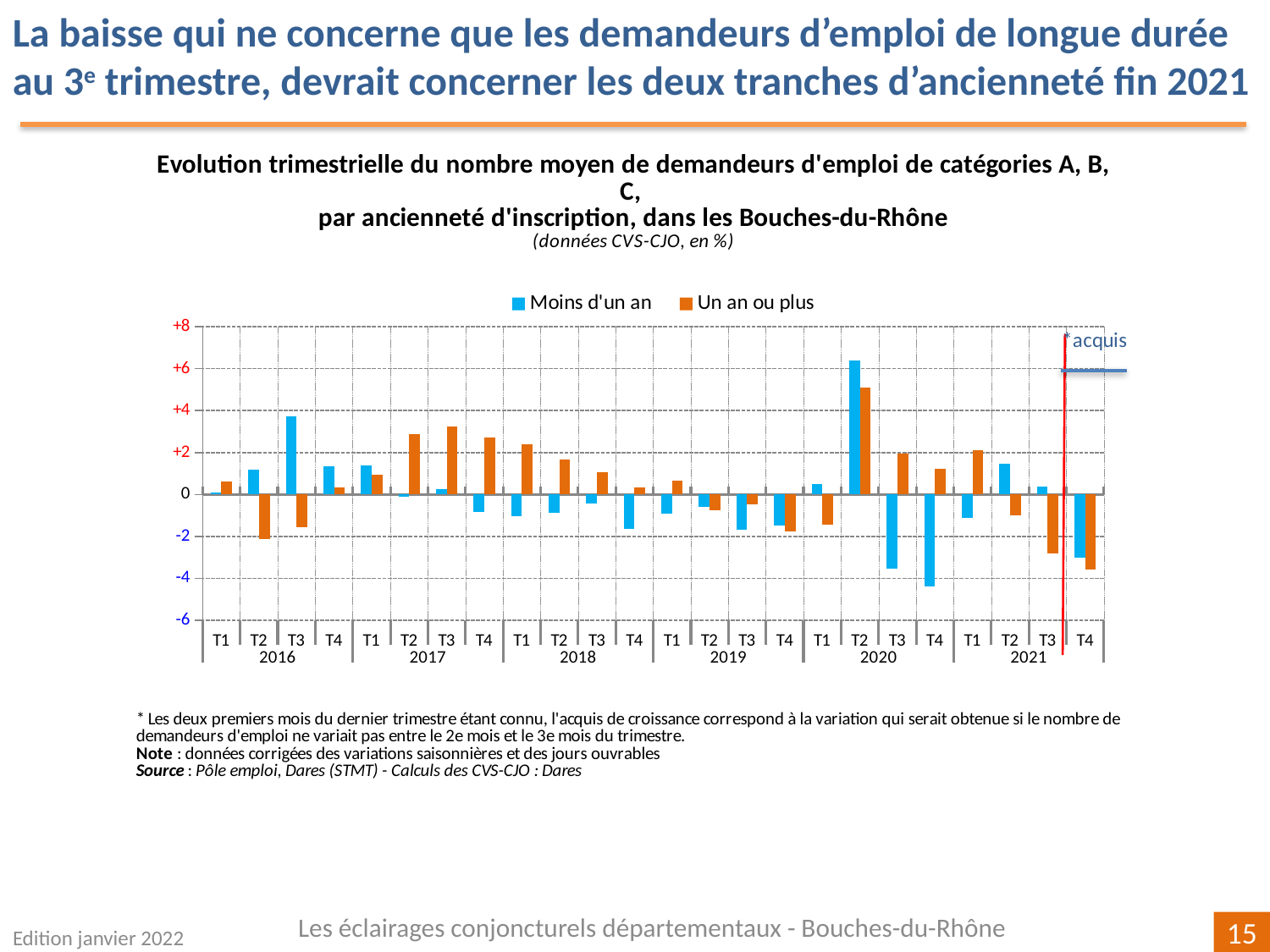
Is the value for 'Moins d'un an' in T2 2020 greater or less than +4? greater What kind of chart is shown on the slide? bar chart In which quarter is the value for 'Un an ou plus' lowest? T4 2021 In T2 2020, which series has the larger value, 'Moins d'un an' or 'Un an ou plus'? Moins d'un an In which quarter is the value for 'Un an ou plus' highest? T2 2020 Is the value for 'Un an ou plus' in T3 2017 greater or less than +2? greater In which quarter is the value for 'Moins d'un an' highest? T2 2020 In which quarter is the value for 'Moins d'un an' lowest? T4 2020 What are the two series named in the legend? Moins d'un an; Un an ou plus How many quarters are plotted along the x axis? 24 How many series does the legend list? 2 Is the value for 'Moins d'un an' in T4 2020 greater or less than -2? less